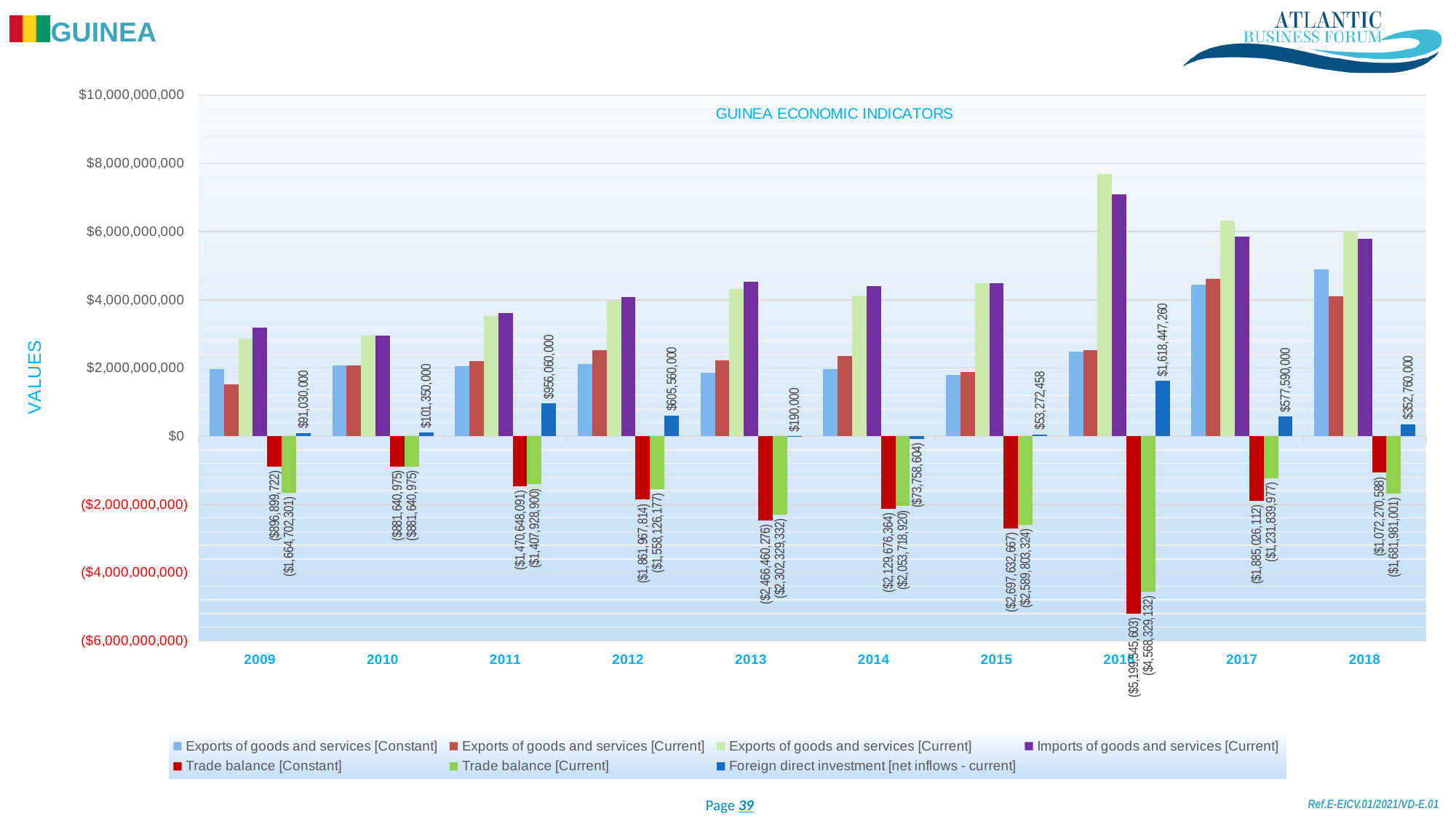
What is the Trade balance [Current] value for 2016? ($4,568,329,132) Which year has the larger Foreign direct investment [net inflows - current], 2011 or 2012? 2011 What is the value of Foreign direct investment [net inflows - current] in 2011? $956,060,000 Is the value of Imports of goods and services [Current] in 2016 greater or less than $6,000,000,000? greater How many series does the chart legend list? 7 What type of chart is shown on the slide? bar chart In which year is Trade balance [Current] lowest (most negative)? 2016 What is the value of Foreign direct investment [net inflows - current] in 2016? $1,618,447,260 In which year is Foreign direct investment [net inflows - current] highest? 2016 What is the title of the chart? GUINEA ECONOMIC INDICATORS How many years are shown on the x axis of the chart? 10 What is the difference between Foreign direct investment [net inflows - current] in 2017 and in 2018? $224,830,000